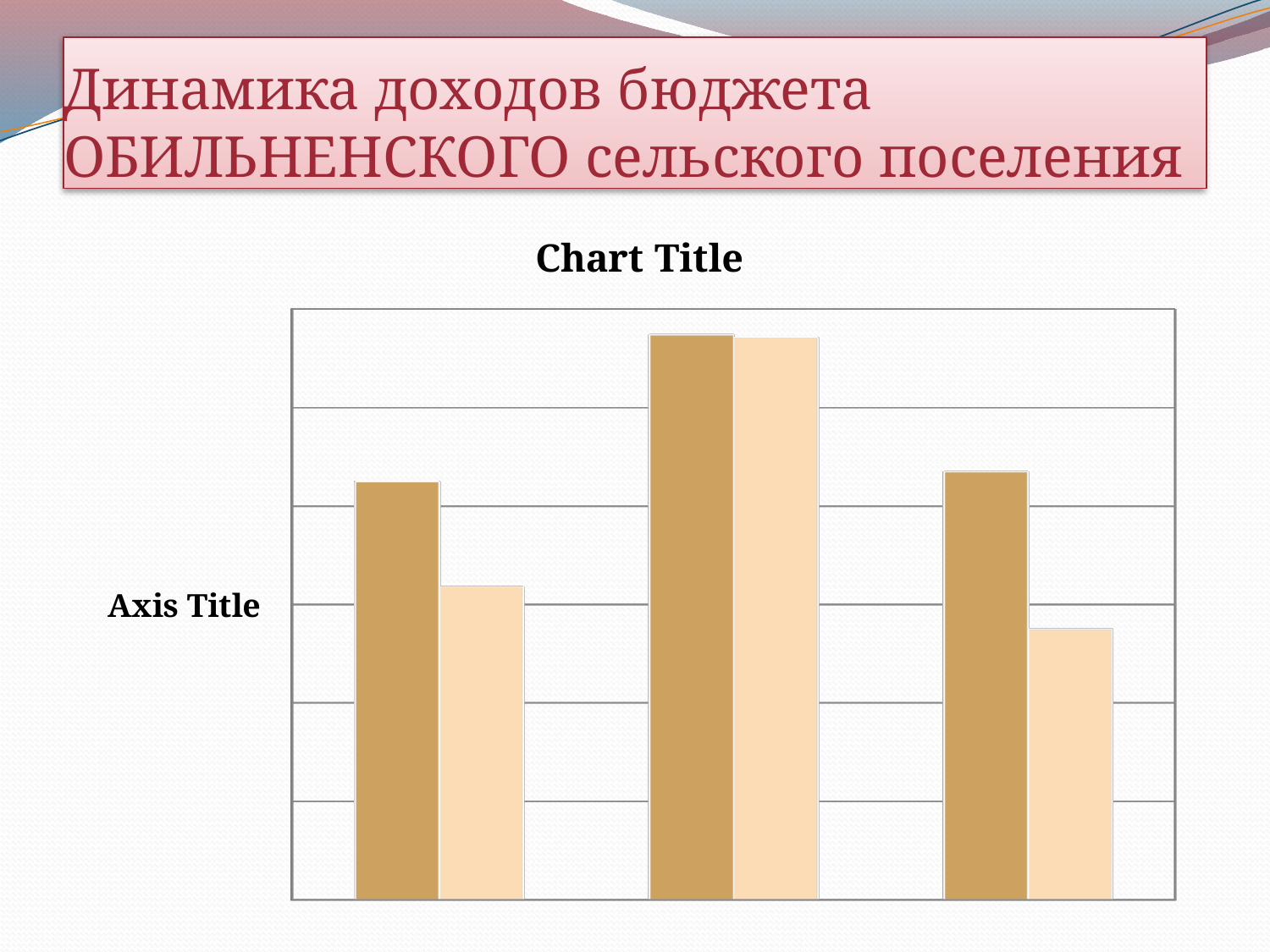
What kind of chart is shown on the slide? bar chart In the right category group, which bar is taller: the dark tan bar or the light beige bar? the dark tan bar How many groups of bars (categories) does the chart show? 3 In the left category group, which bar is taller: the dark tan bar or the light beige bar? the dark tan bar How many bars are plotted in total on the chart? 6 What is the title text shown above the chart? Chart Title Which category group has the shortest light-coloured bar: the left, middle or right group? right What text is shown as the vertical axis title of the chart? Axis Title How many bars are in each category group? 2 Which category group has the tallest bars: the left, middle or right group? middle